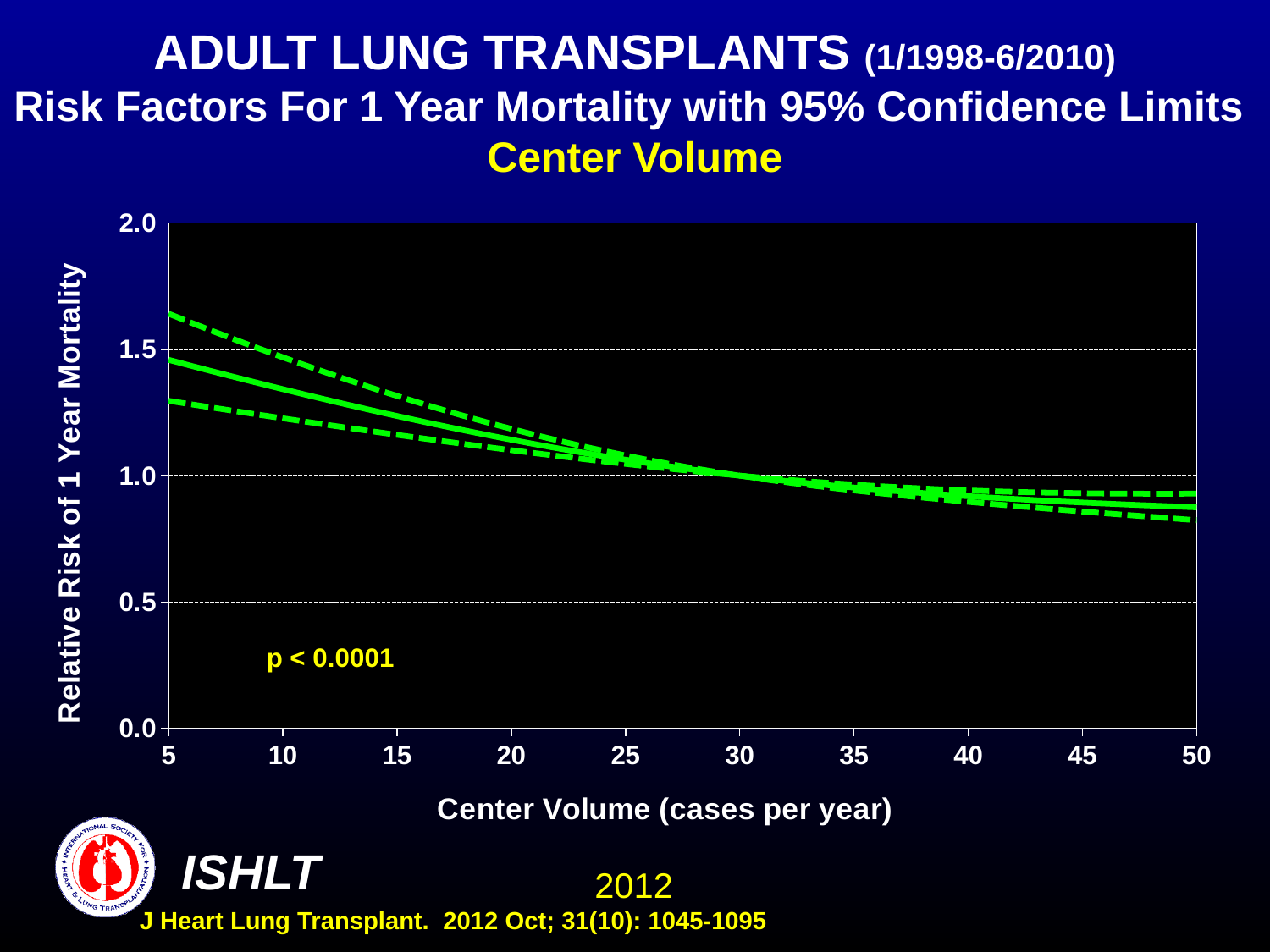
Is the relative risk of 1 year mortality at a center volume of 5 cases per year greater or less than 1.0? greater At which center volume shown on the x axis is the relative risk of 1 year mortality highest? 5 How many curves (solid and dashed) are plotted on the chart? 3 What is the label of the x axis? Center Volume (cases per year) Is the upper confidence limit at a center volume of 5 cases per year greater or less than 1.5? greater Is the relative risk of 1 year mortality at a center volume of 50 cases per year greater or less than 1.0? less Which has the larger relative risk of 1 year mortality: a center volume of 5 or a center volume of 50 cases per year? 5 Does the relative risk of 1 year mortality rise or fall as center volume increases? fall What p-value is printed on the chart? p < 0.0001 What kind of chart is shown on the slide? line chart